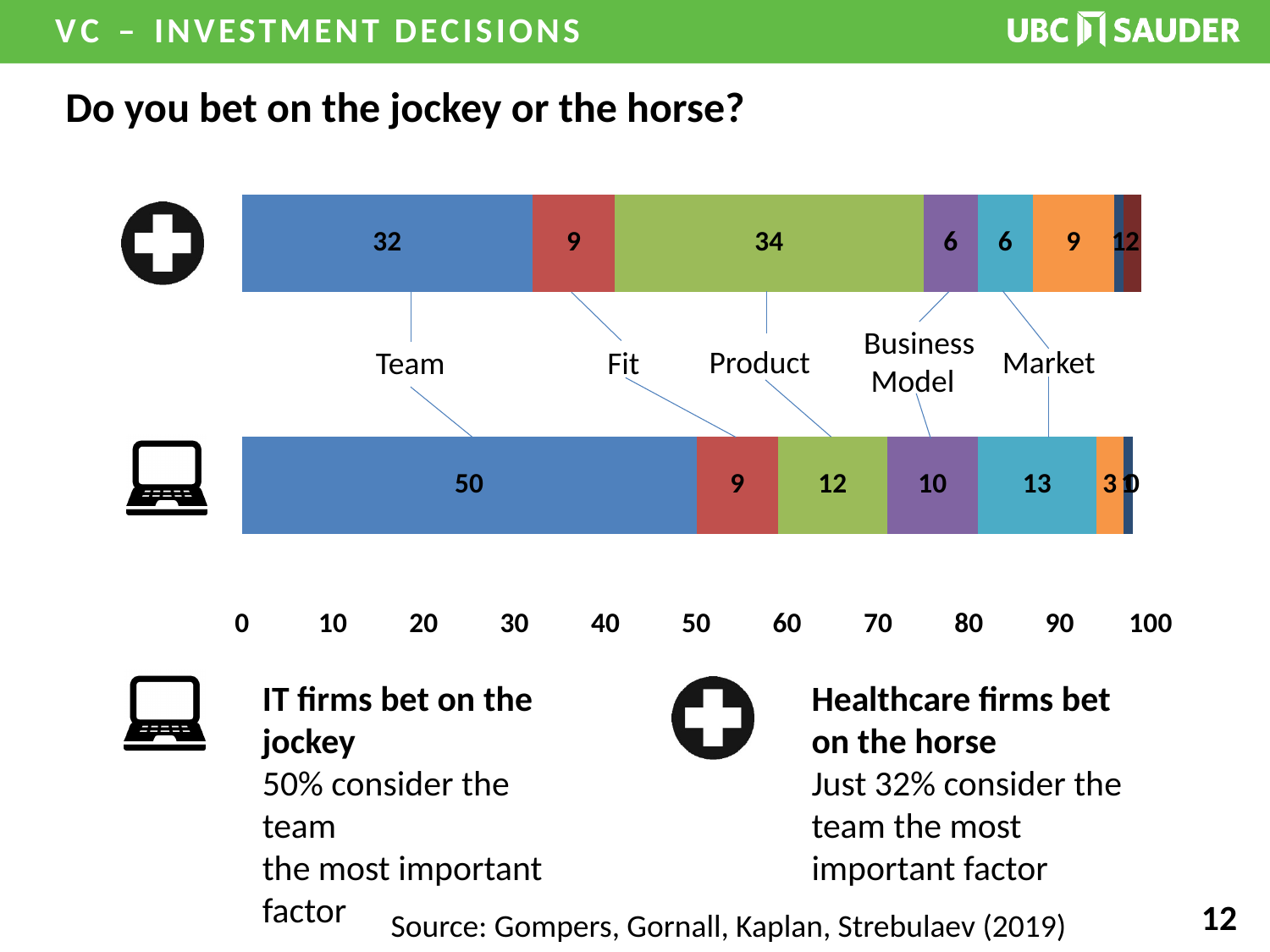
Which factor has the largest segment in the healthcare bar? Product What is the value of the Business Model segment for IT firms? 10 What is the value of the Product segment for healthcare firms? 34 What percentage of IT firms consider the team the most important factor? 50 What is the value of the Market segment in the IT bar? 13 Which factor has the largest segment in the IT bar? Team Which is larger: the Team value for IT firms or the Team value for healthcare firms? IT firms What is the value of the Fit segment in the healthcare bar? 9 What is the value of the Team segment in the healthcare bar? 32 What kind of chart is shown on the slide? Stacked bar chart What is the difference between the Team value for IT firms and the Team value for healthcare firms? 18 What is the highest value shown on the horizontal axis? 100